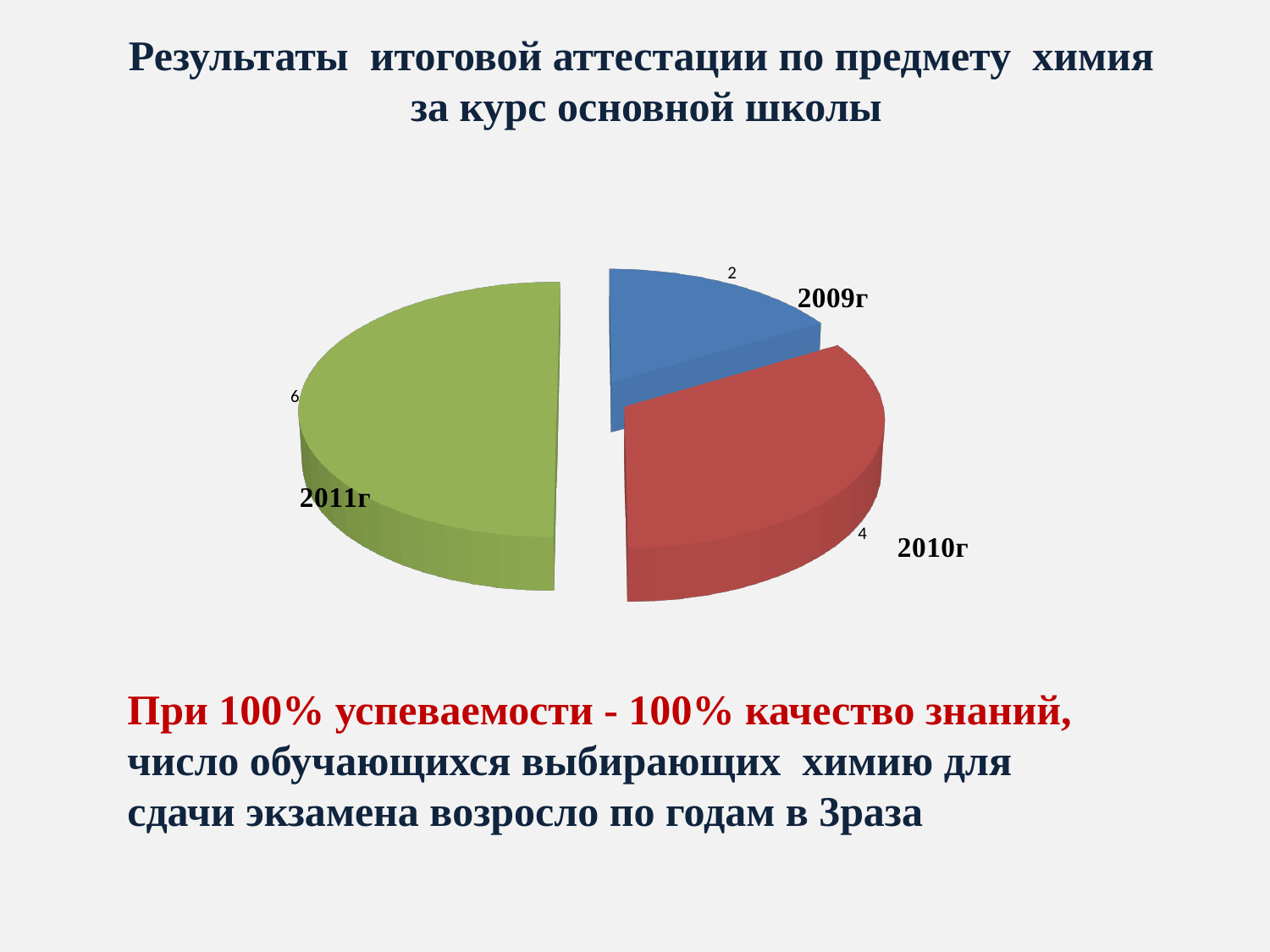
What colour is the slice for 2010г? Red Which year has the largest slice of the pie? 2011г Which year has the smallest slice of the pie? 2009г What kind of chart is shown on the slide? Pie chart What is the total of all the slice values in the pie chart? 12 What value is shown for the 2010г slice? 4 Which is larger, the value for 2010г or the value for 2009г? 2010г What value is shown for the 2009г slice? 2 What share of the pie does the 2011г slice represent? 50% How many slices does the pie chart have? 3 What value is shown for the 2011г slice? 6 What is the difference between the values for 2011г and 2009г? 4